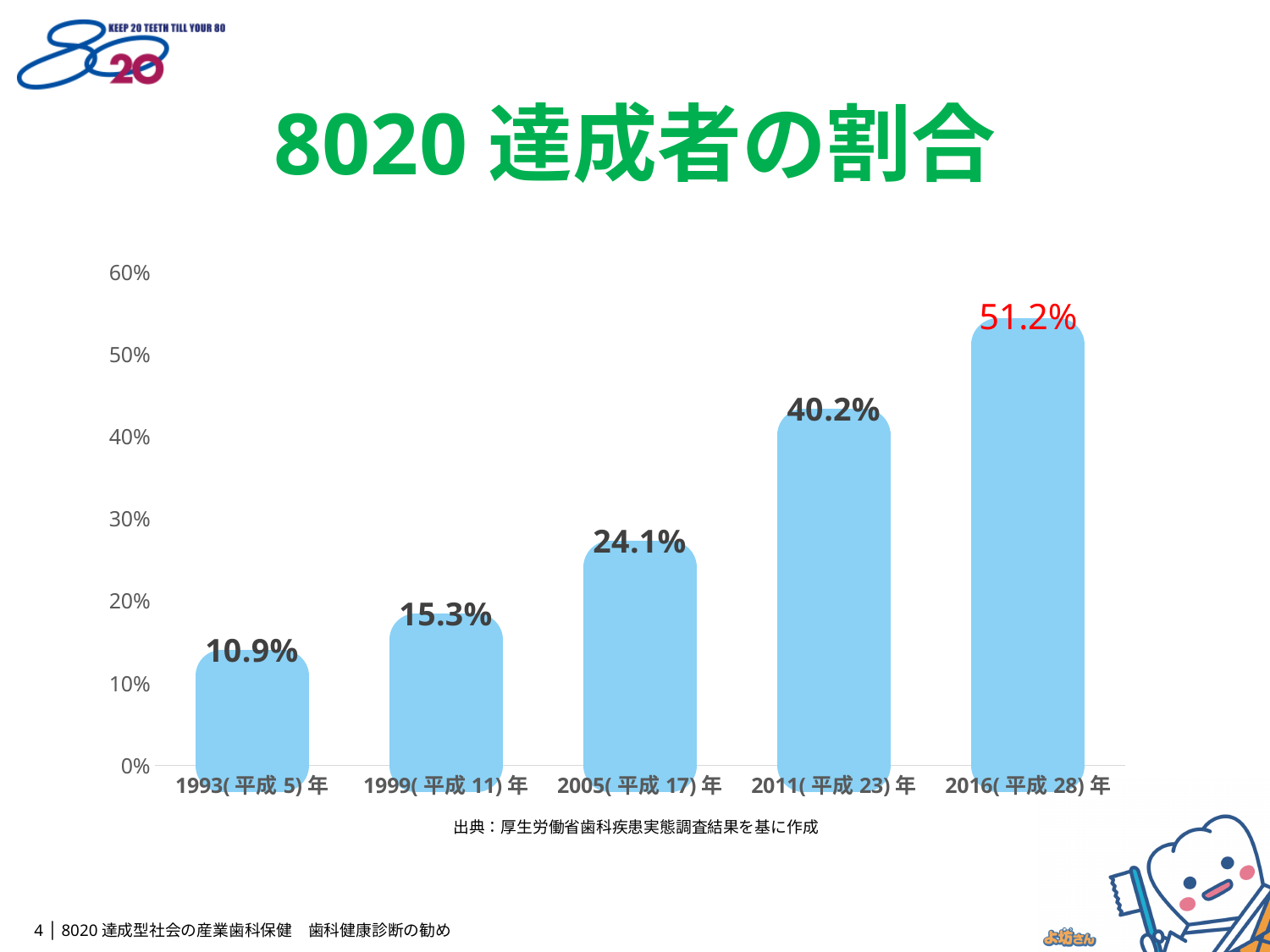
How many years are shown on the x axis? 5 What is the value for 1993(平成5)年? 10.9% Which year has the lowest value? 1993(平成5)年 What is the difference between the values for 2016(平成28)年 and 2011(平成23)年? 11.0% Which year has the highest value? 2016(平成28)年 What is the value for 2005(平成17)年? 24.1% Which is larger, the value for 2005(平成17)年 or the value for 1999(平成11)年? 2005(平成17)年 Do the values rise or fall from 1993 to 2016? rise What is the value for 2016(平成28)年? 51.2% Is the value for 2011(平成23)年 greater or less than 30%? greater What is the difference between the values for 1999(平成11)年 and 1993(平成5)年? 4.4% What kind of chart is shown on the slide? bar chart